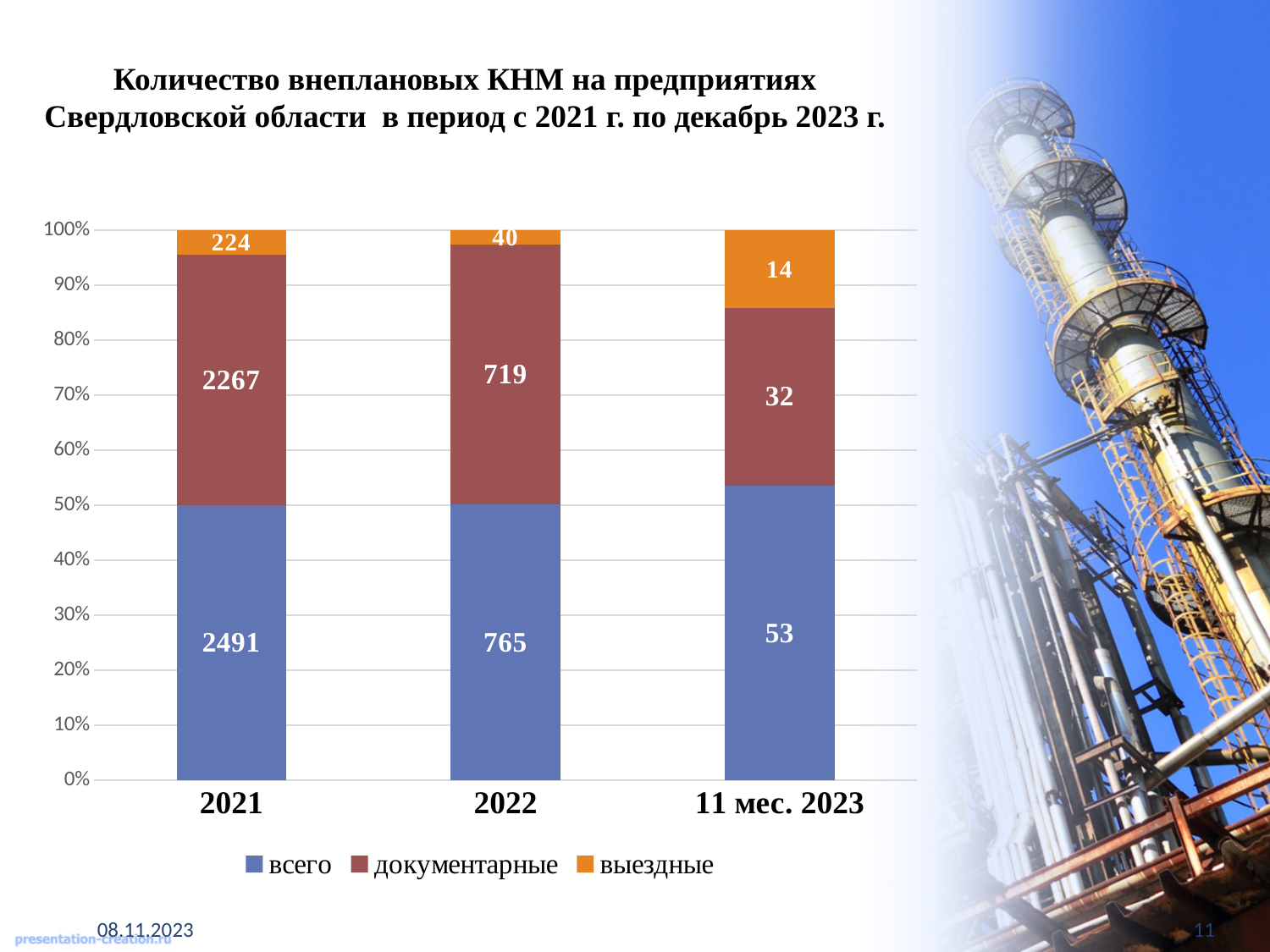
Which category has the lowest value for выездные? 11 мес. 2023 What kind of chart is shown on the slide? Stacked bar chart Which is larger: the выездные value for 2021 or the выездные value for 2022? 2021 How many categories are shown on the x axis? 3 What is the value for всего in 2021? 2491 How many series does the legend list? 3 What is the difference between the всего value for 2021 and the всего value for 2022? 1726 What is the value for выездные in 11 мес. 2023? 14 Which category has the highest value for всего? 2021 What is the difference between the документарные and выездные values in 2022? 679 What is the value for документарные in 2022? 719 What is the value for документарные in 11 мес. 2023? 32